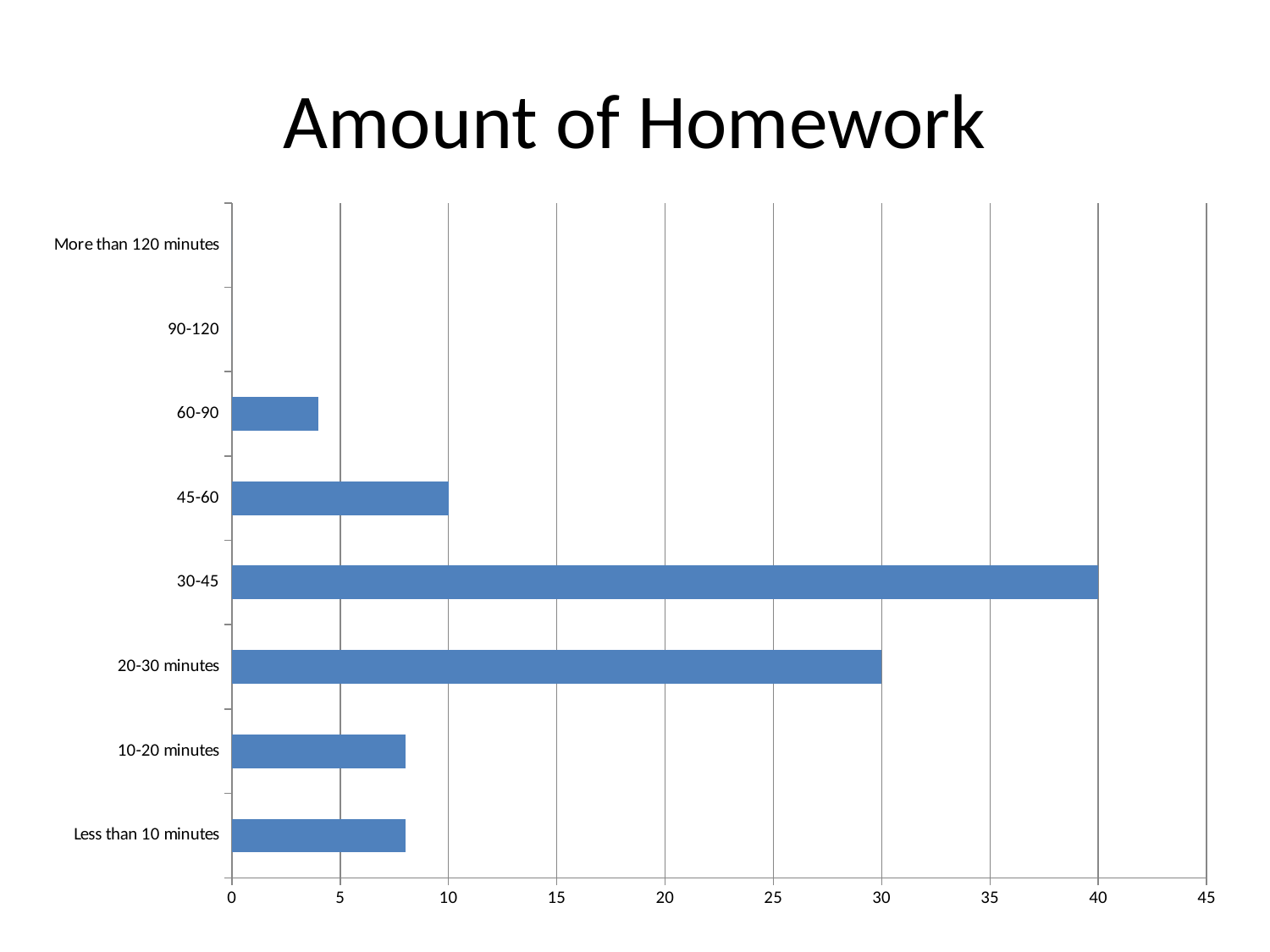
How many categories are listed on the vertical axis of the chart? 8 What is the value for the 20-30 minutes category? 30 Which has a larger value, 45-60 or 60-90? 45-60 What is the title of the chart? Amount of Homework What is the value for the 30-45 category? 40 Which category has the highest value? 30-45 Is the value for 60-90 greater or less than 5? less What is the value for the 45-60 category? 10 What is the difference between the values for 30-45 and 20-30 minutes? 10 What is the difference between the values for 30-45 and 45-60? 30 What kind of chart is shown on the slide? bar chart Is the value for 10-20 minutes greater or less than 5? greater